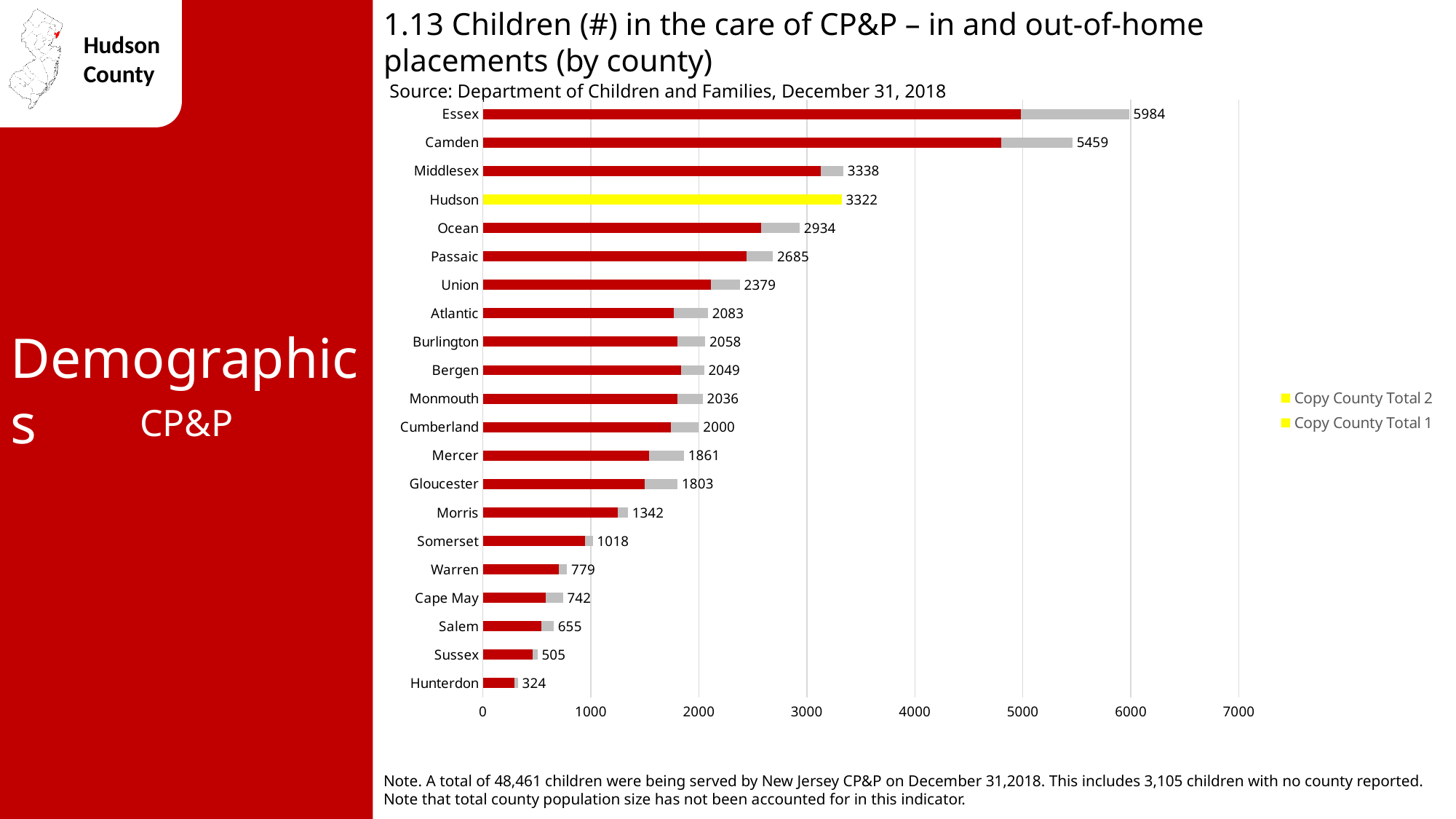
Is the total for Union County greater or less than 2000? greater Which county has the highest total number of children in the care of CP&P? Essex What is the total number of children in the care of CP&P for Hudson County? 3322 Which county has the lowest total number of children in the care of CP&P? Hunterdon How many series does the legend list? 2 What kind of chart is shown on the slide? Bar chart What is the difference between the totals for Middlesex and Hudson? 16 What is the difference between the totals for Essex and Camden? 525 How many counties are shown in the chart? 21 What is the total value shown for Hunterdon County? 324 What is the total value shown for Essex County? 5984 Which county has a larger total, Ocean or Passaic? Ocean